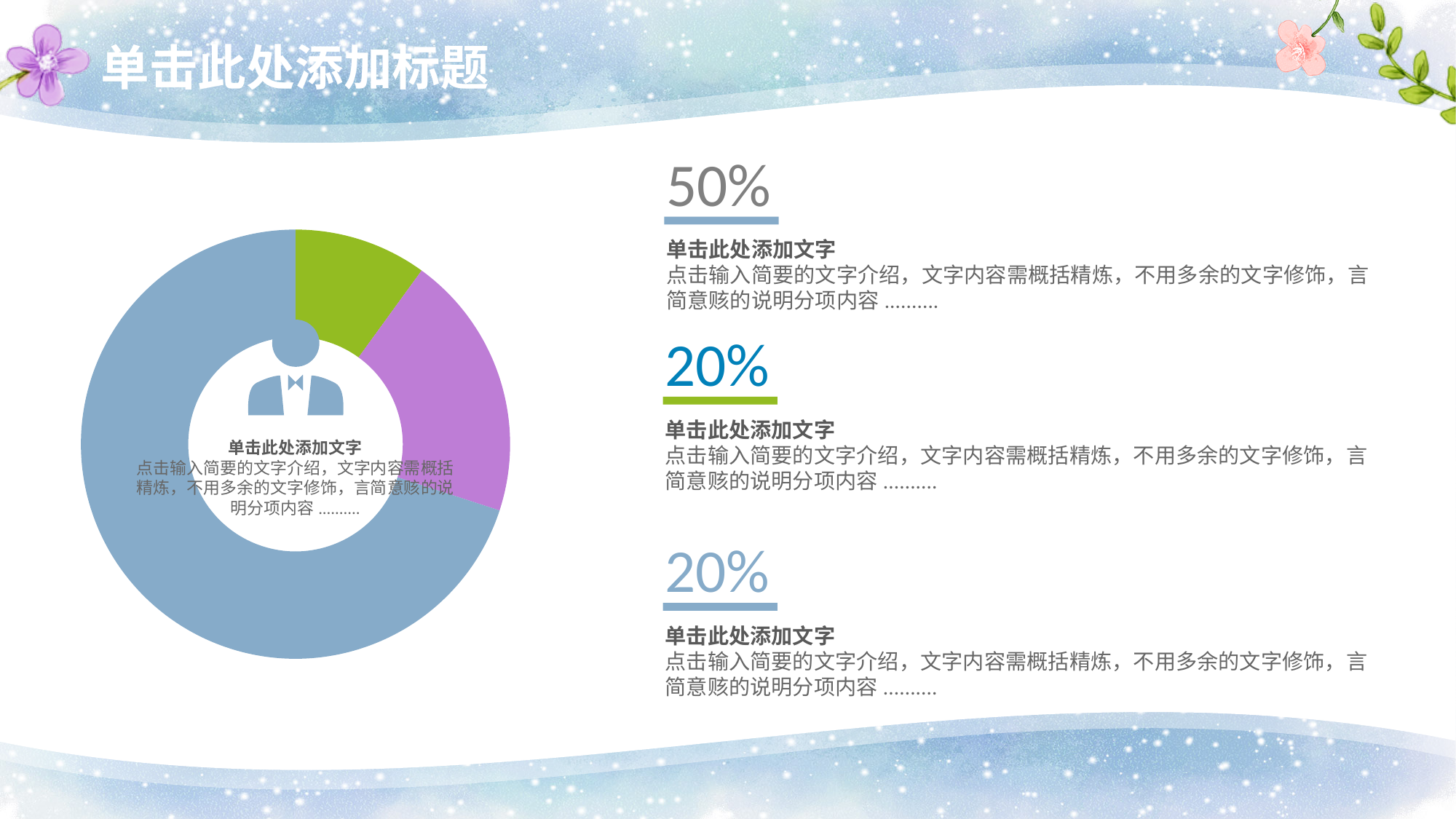
Does the blue slice of the donut chart take up more or less than half of the ring? more In the donut chart, is the purple slice larger or smaller than the green slice? larger Which colour slice is the largest in the donut chart? blue What kind of chart is shown on the left of the slide? pie chart (donut) What icon appears in the centre of the donut chart? a person (businessman) icon What three colours are used for the slices of the donut chart? blue, green and purple In the donut chart, is the blue slice larger or smaller than the purple slice? larger Which colour slice is the smallest in the donut chart? green